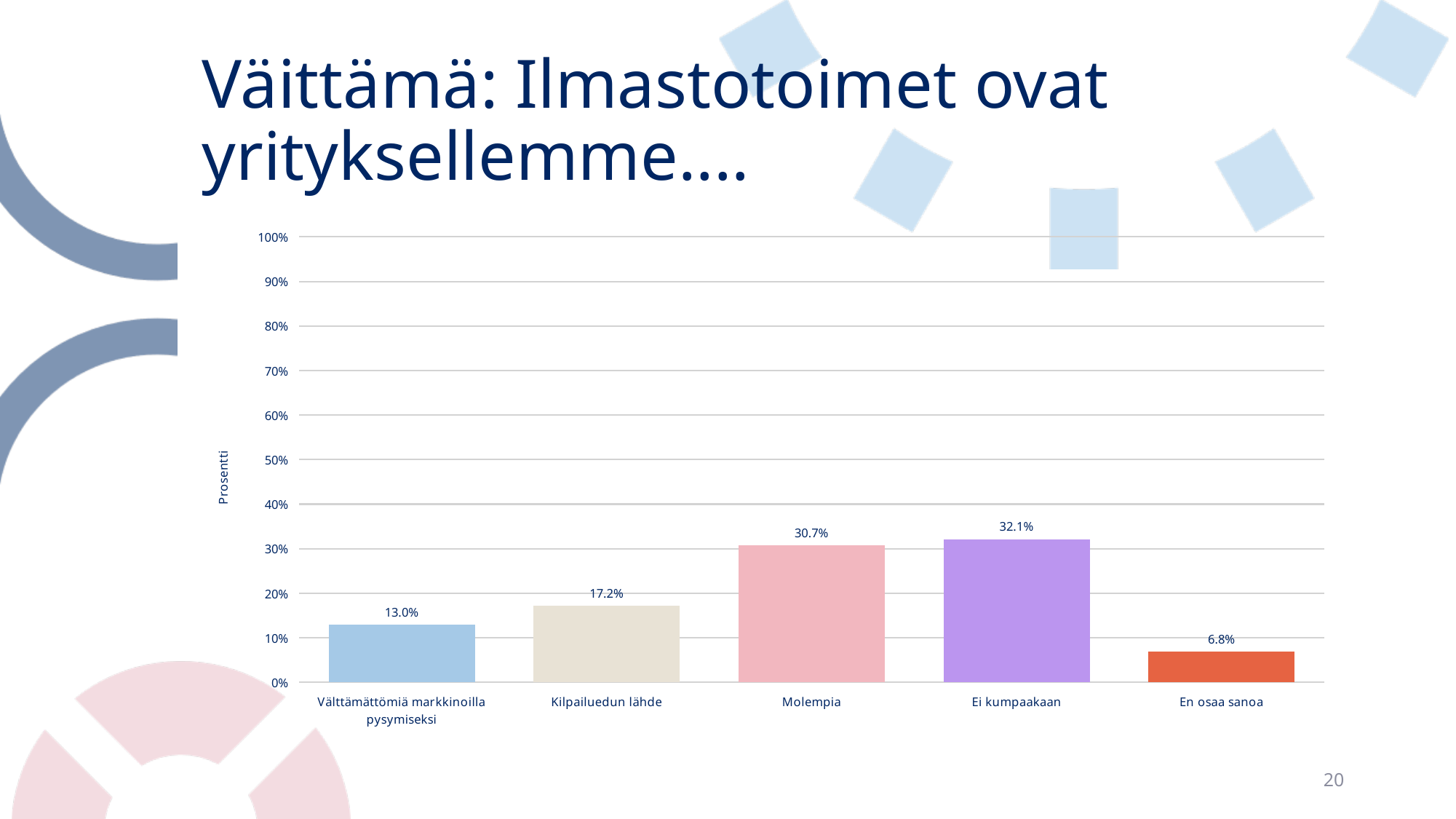
What is the value for "Molempia"? 30.7% What is the difference between the values for "Ei kumpaakaan" and "Molempia"? 1.4% What is the difference between the values for "Kilpailuedun lähde" and "Välttämättömiä markkinoilla pysymiseksi"? 4.2% What kind of chart is shown on the slide? Bar chart What is the value for "Kilpailuedun lähde"? 17.2% Which category has the lowest value? En osaa sanoa Which category has the highest value? Ei kumpaakaan How many categories are shown on the x axis? 5 What is the value for "Välttämättömiä markkinoilla pysymiseksi"? 13.0% What is the label of the vertical axis? Prosentti What is the value for "En osaa sanoa"? 6.8% Which is larger, the value for "Kilpailuedun lähde" or the value for "En osaa sanoa"? Kilpailuedun lähde